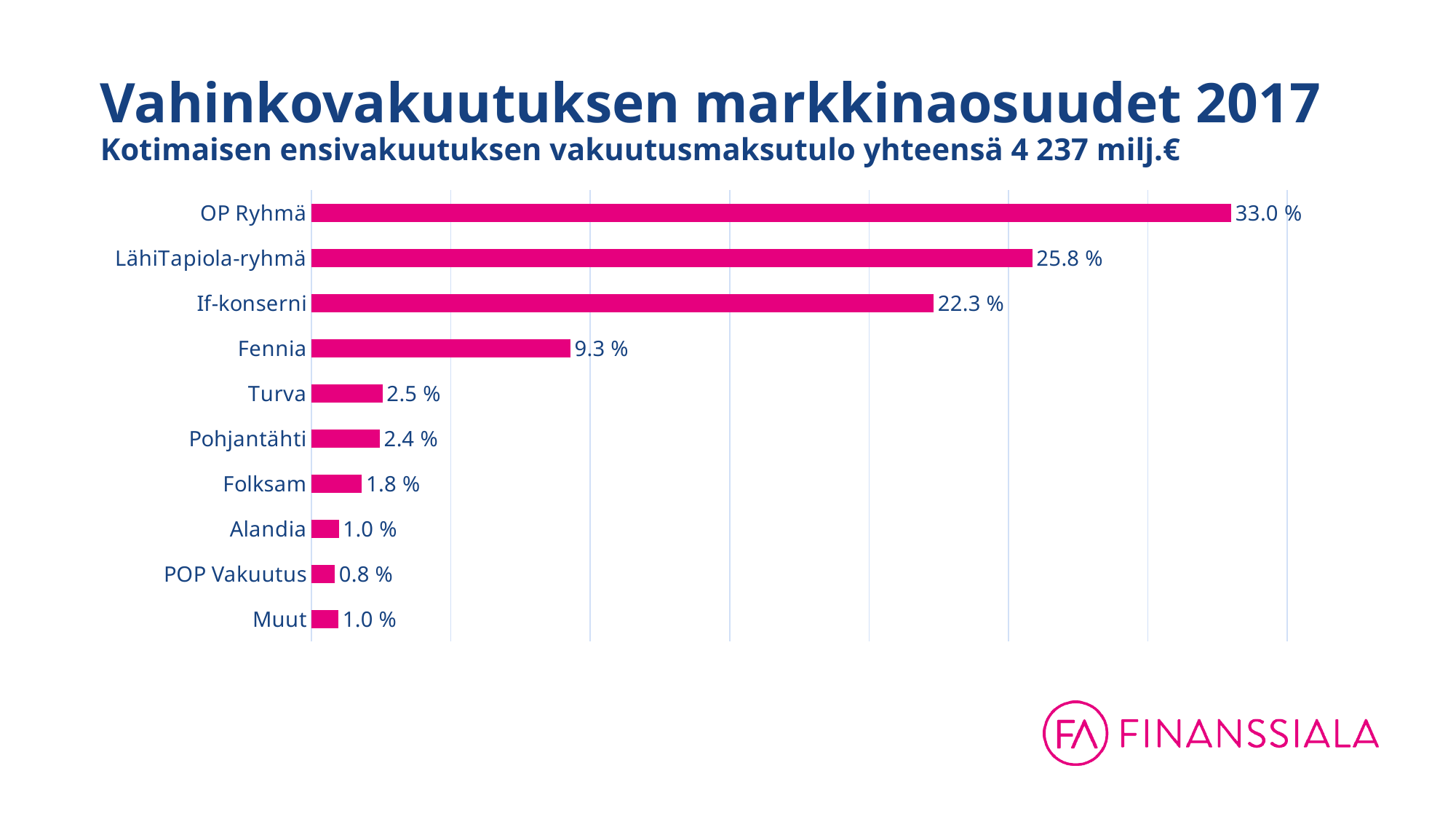
How many categories are shown in the chart? 10 Which has a larger market share, LähiTapiola-ryhmä or If-konserni? LähiTapiola-ryhmä What is the market share shown for OP Ryhmä? 33.0 % What is the difference in market share between If-konserni and Fennia? 13.0 % What is the title of the slide? Vahinkovakuutuksen markkinaosuudet 2017 What is the market share shown for POP Vakuutus? 0.8 % What is the market share shown for Fennia? 9.3 % Which has a larger market share, Turva or Folksam? Turva What is the difference in market share between OP Ryhmä and LähiTapiola-ryhmä? 7.2 % What kind of chart is shown on the slide? Bar chart Which category has the lowest market share? POP Vakuutus Which category has the highest market share? OP Ryhmä